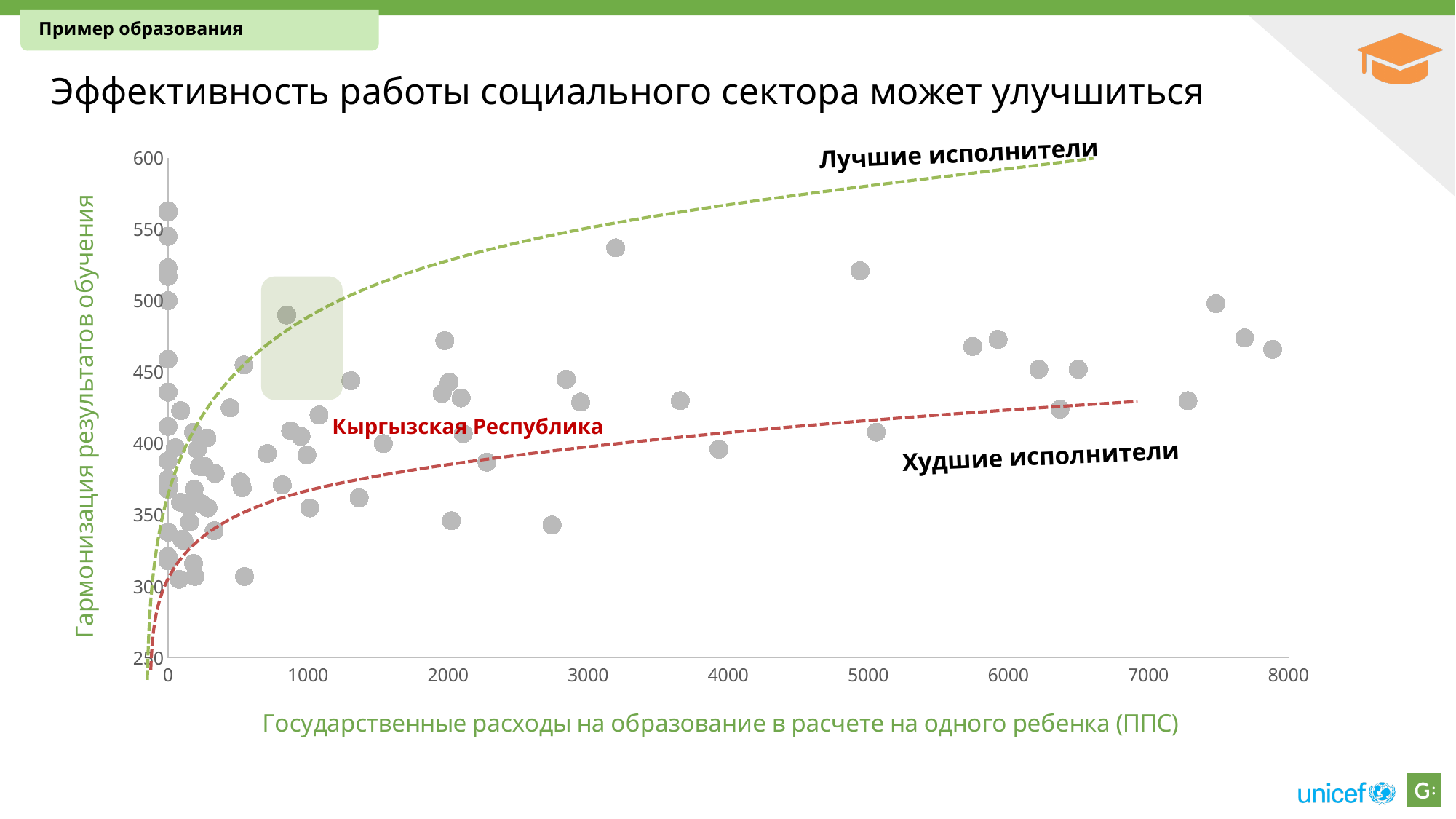
Do the dashed trend lines rise or fall as the x-axis value increases? rise What is the title of the x axis? Государственные расходы на образование в расчете на одного ребенка (ППС) Which country is labelled by name on the chart? Кыргызская Республика What is the label of the upper dashed line on the chart? Лучшие исполнители Is the y-axis value for Кыргызская Республика greater or less than 400? greater What kind of chart is shown on the slide? scatter chart What is the highest value shown on the x axis? 8000 What is the highest value shown on the y axis? 600 Is the x-axis value for Кыргызская Республика greater or less than 500? greater Is the x-axis value (government spending per child) for Кыргызская Республика greater or less than 2000? less